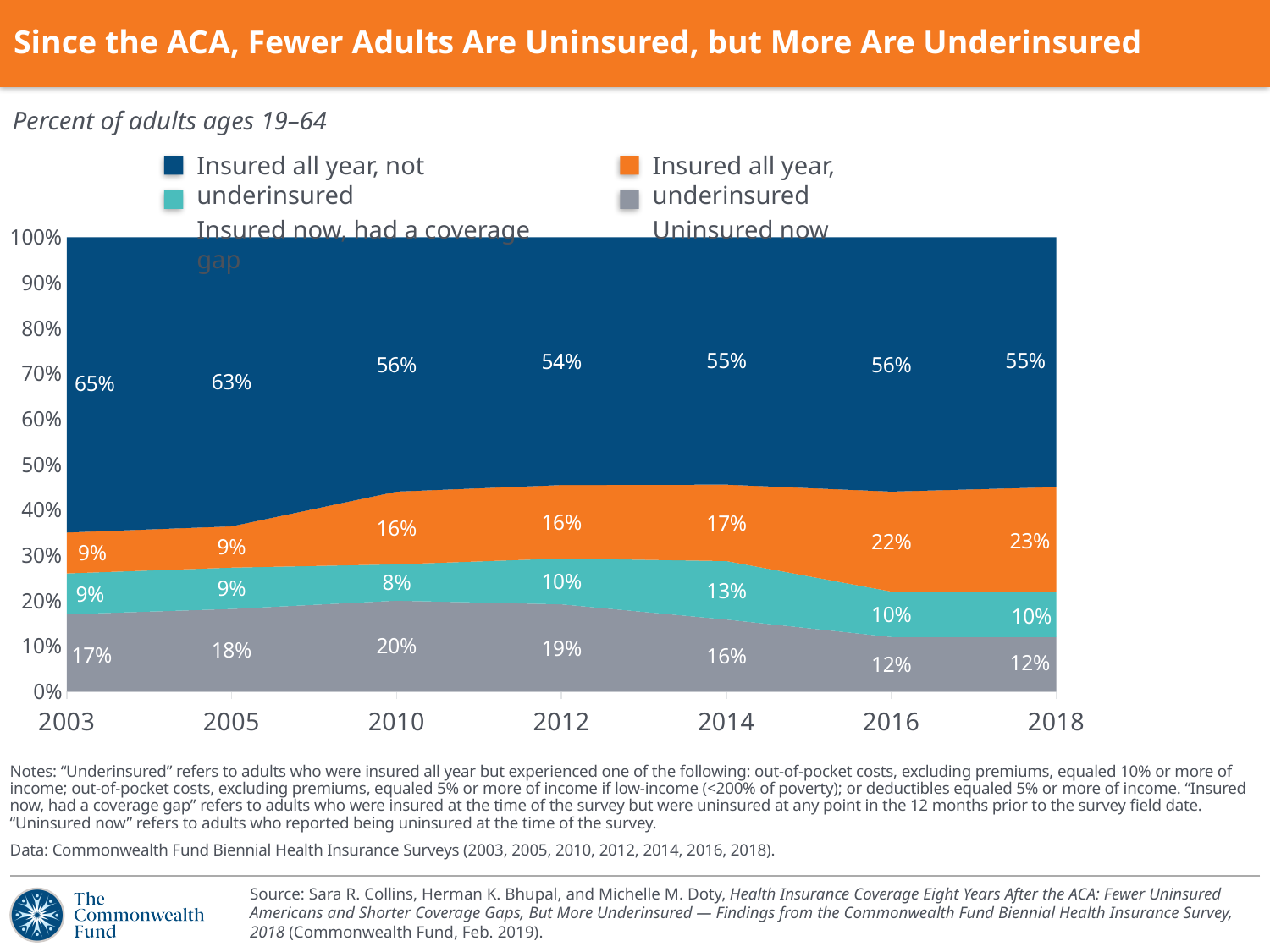
What kind of chart is shown on the slide? Stacked area chart What percentage of adults were "Uninsured now" in 2010? 20% What percentage of adults were "Uninsured now" in 2003? 17% How many survey years are shown on the x axis? 7 What percentage of adults were "Insured all year, underinsured" in 2018? 23% In which year was the share of adults "Insured all year, not underinsured" highest? 2003 By how many percentage points did the share of adults "Insured all year, underinsured" change from 2003 to 2018? 14 percentage points How many series does the legend list? 4 Which year had a larger share of adults who were "Insured now, had a coverage gap": 2014 or 2016? 2014 In which year was the share of adults "Uninsured now" highest? 2010 Does the share of adults "Insured all year, underinsured" rise or fall from 2003 to 2018? Rise In which year was the share of adults "Insured all year, not underinsured" lowest? 2012